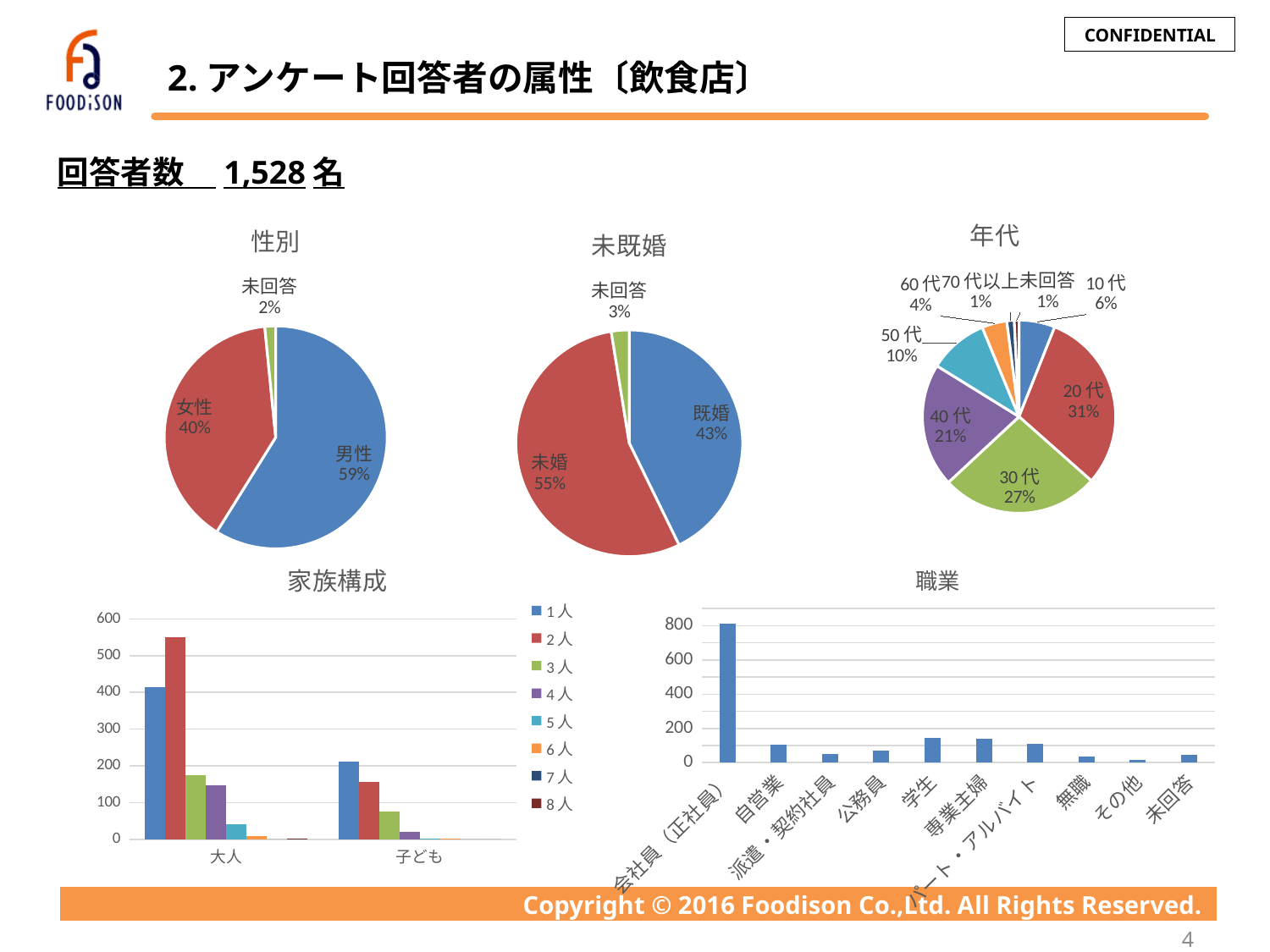
In the 家族構成 chart, is the value for 2人 in the 大人 group greater or less than 500? greater In the 家族構成 chart, which is larger for 大人: 1人 or 2人? 2人 In the 未既婚 pie chart, what is the difference in percentage points between 未婚 and 既婚? 12 In the 性別 pie chart, what percentage is 男性? 59% In the 未既婚 pie chart, what is the share for 未婚? 55% In the 年代 pie chart, which age group has the largest share? 20代 In the 年代 pie chart, how many slices are there? 8 What type of chart is the 職業 chart? bar chart In the 職業 chart, which category has the highest value? 会社員（正社員） In the 年代 pie chart, what percentage is 40代? 21% In the 性別 pie chart, which category has the smallest share? 未回答 In the 家族構成 chart, how many series does the legend list? 8